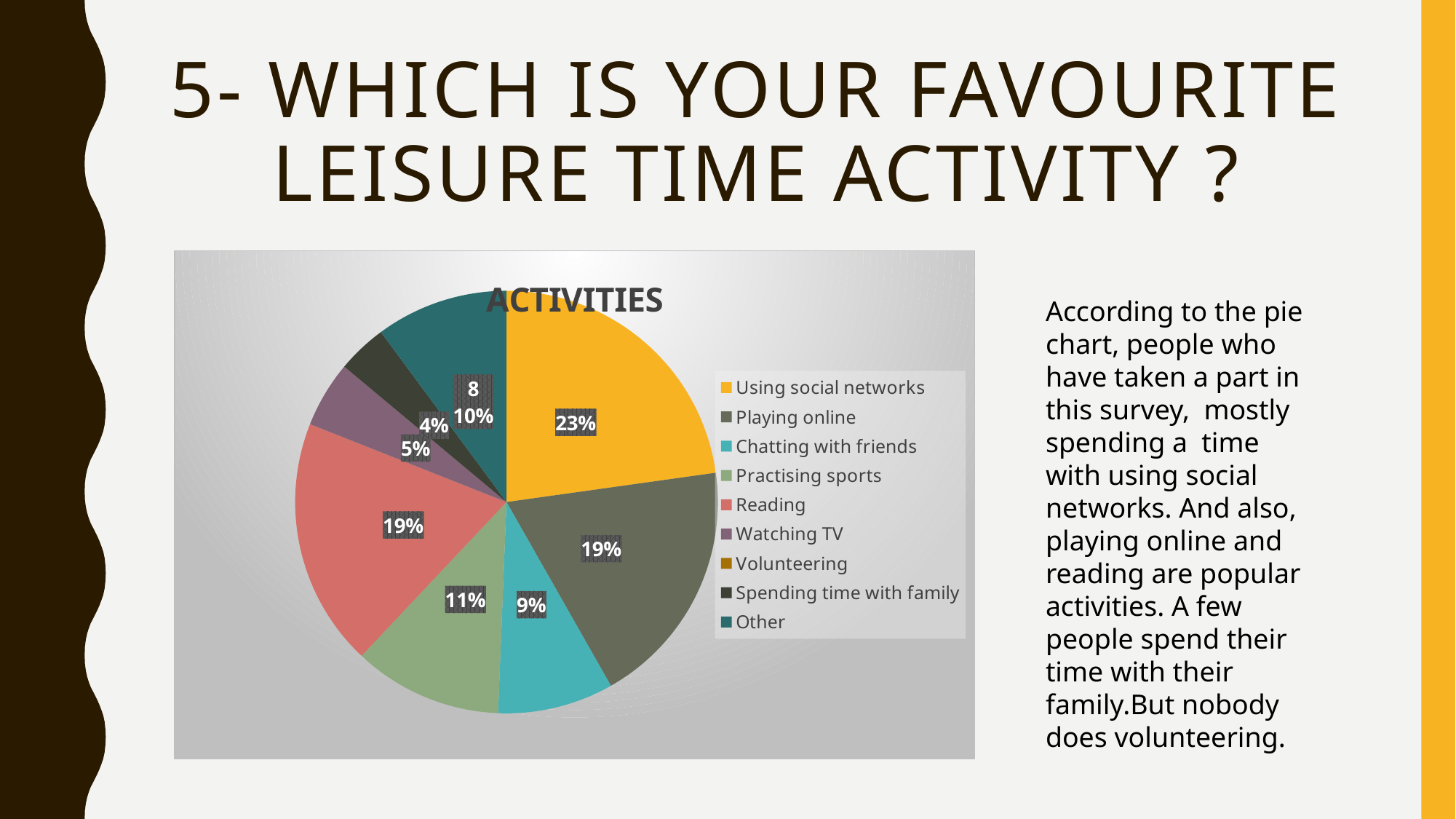
What percentage of the pie is Watching TV? 5% What percentage of the pie is Practising sports? 11% What percentage of the pie is Reading? 19% Which activity has the largest slice of the pie? Using social networks What kind of chart is shown on the slide? pie chart What is the difference between the Using social networks slice and the Playing online slice? 4% What percentage of the pie is Spending time with family? 4% What is the title of the chart? ACTIVITIES What percentage of the pie is Using social networks? 23% Which slice is larger, Practising sports or Chatting with friends? Practising sports What percentage of the pie is Chatting with friends? 9% How many entries does the legend list? 9